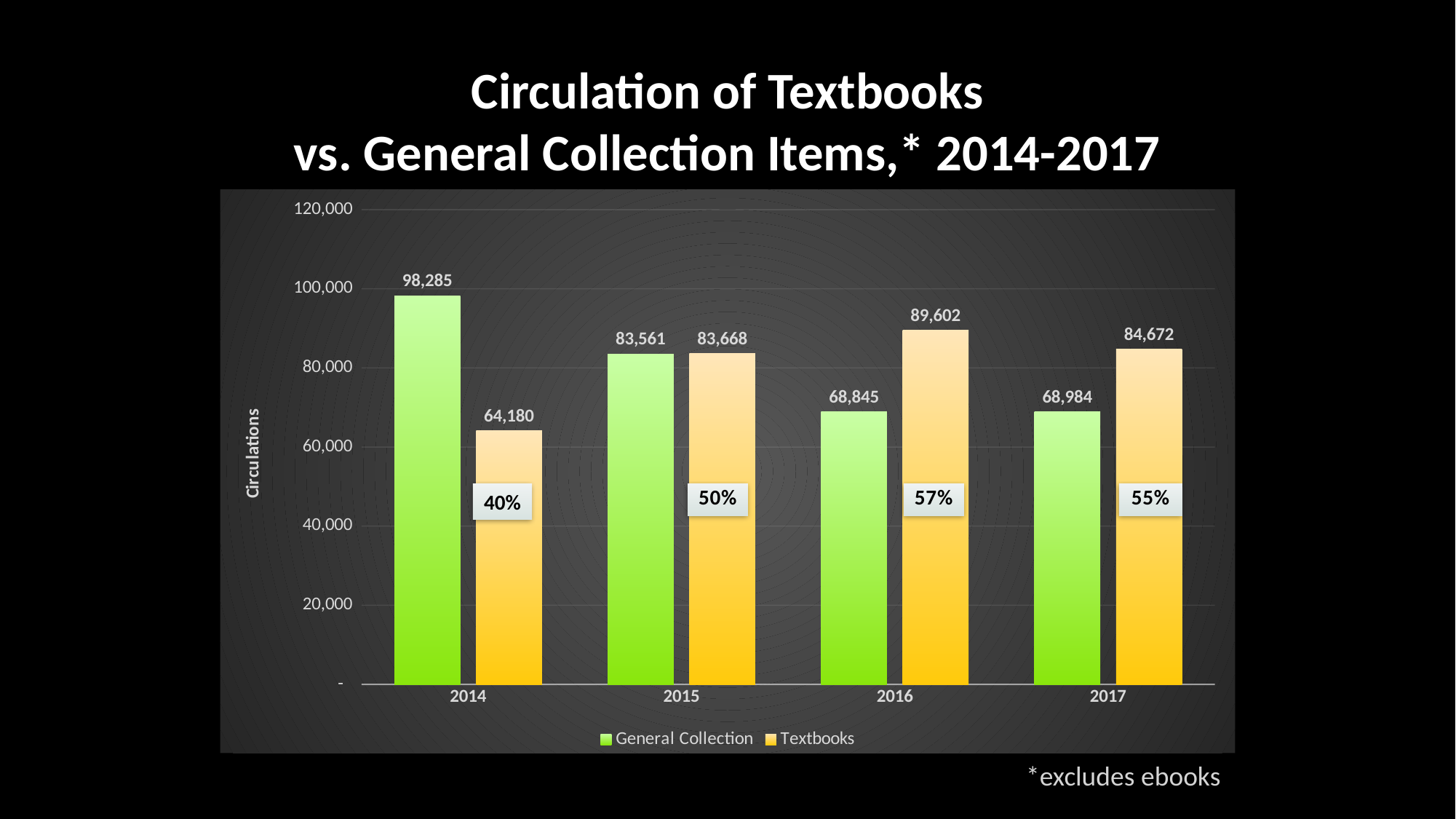
In which year was the Textbooks circulation highest? 2016 How many series does the legend list? 2 What percentage label is shown on the Textbooks bar for 2015? 50% How many years are shown on the x axis? 4 What was the Textbooks circulation in 2017? 84,672 Which was larger in 2017, General Collection or Textbooks circulation? Textbooks In which year was the General Collection circulation lowest? 2016 What kind of chart is shown on the slide? Bar chart What is the difference between the General Collection and Textbooks circulation in 2014? 34,105 What was the General Collection circulation in 2014? 98,285 What was the Textbooks circulation in 2016? 89,602 Does the General Collection circulation rise or fall from 2014 to 2016? Fall